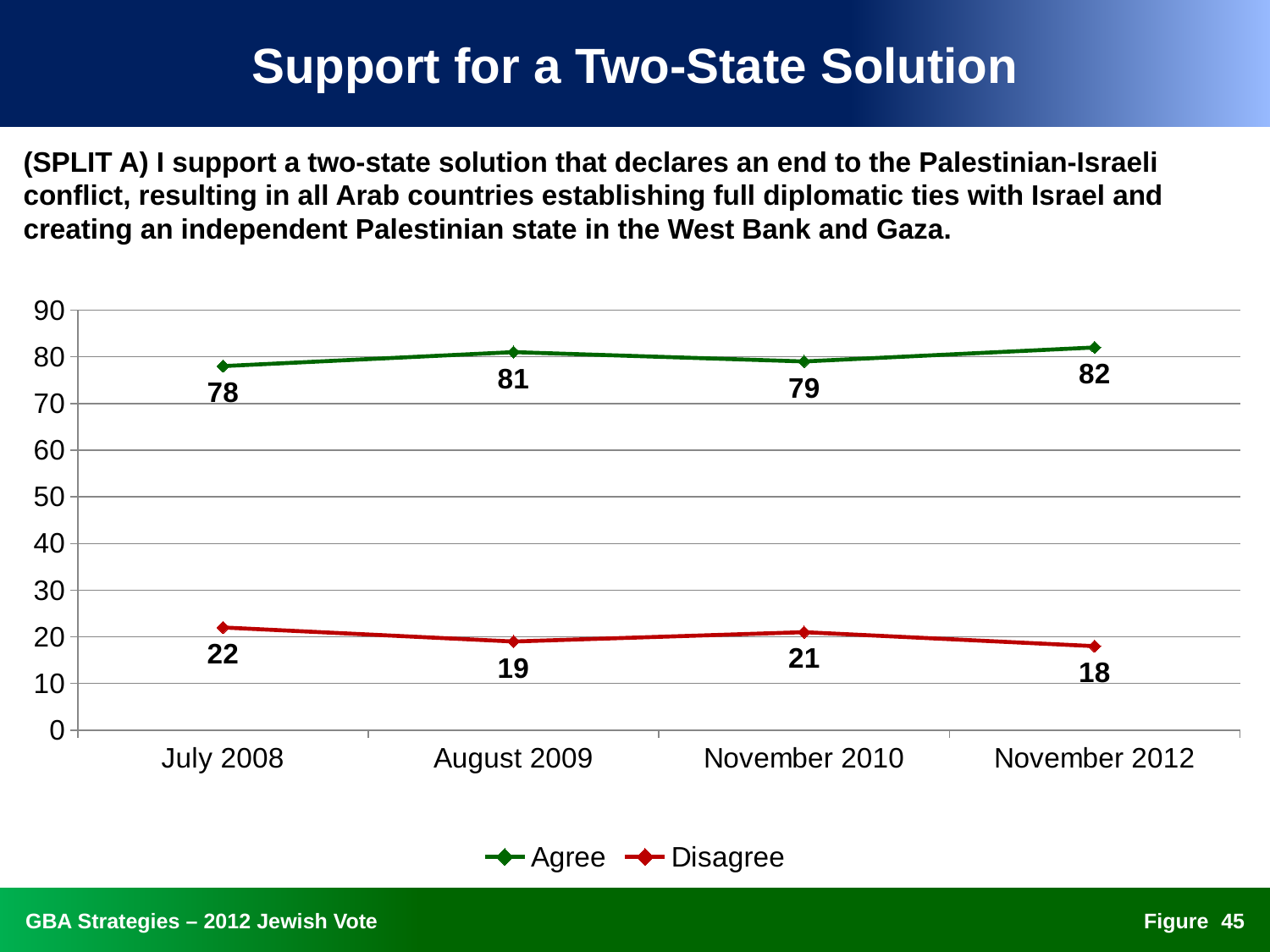
What is the Agree value for November 2010? 79 What kind of chart is shown on the slide? line chart What is the Disagree value for November 2012? 18 What is the difference between the Agree and Disagree values in August 2009? 62 Is the Agree value for August 2009 greater or less than 80? greater What colour is the Disagree line? red What is the Agree value for July 2008? 78 How many series does the legend list? 2 In which period is the Agree value highest? November 2012 How many time periods are shown on the x axis? 4 Which is larger, the Disagree value for July 2008 or for November 2010? July 2008 In which period is the Disagree value lowest? November 2012